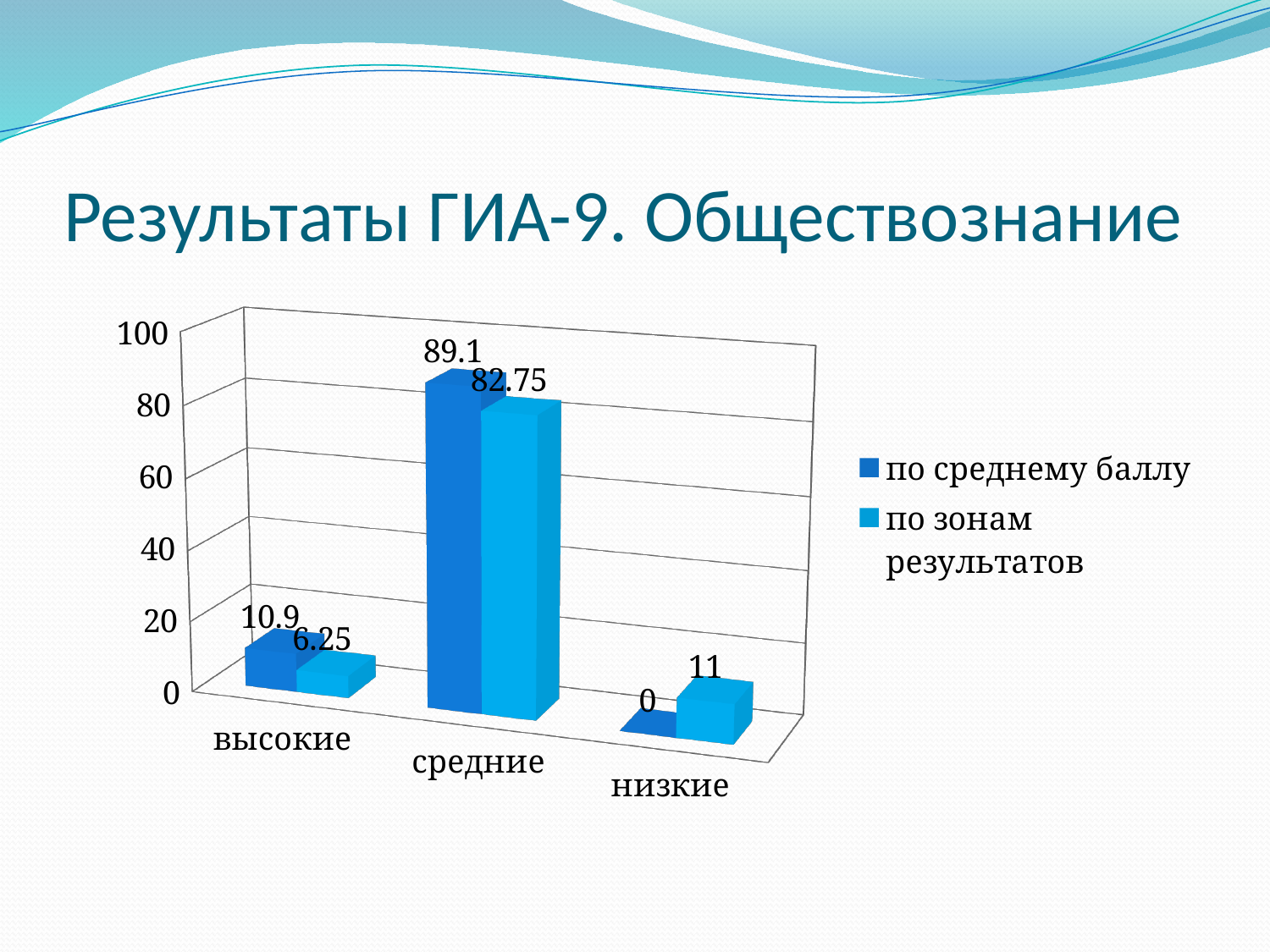
Which category has the highest value in the "по среднему баллу" series? средние What is the value for "высокие" in the "по среднему баллу" series? 10.9 What is the difference between the "по среднему баллу" and "по зонам результатов" values for "средние"? 6.35 What is the value for "средние" in the "по среднему баллу" series? 89.1 For "высокие", which series has the larger value: "по среднему баллу" or "по зонам результатов"? по среднему баллу What is the value for "средние" in the "по зонам результатов" series? 82.75 What is the value for "низкие" in the "по зонам результатов" series? 11 Which category has the lowest value in the "по зонам результатов" series? высокие What is the value for "низкие" in the "по среднему баллу" series? 0 What kind of chart is shown on the slide? bar chart How many series does the legend list? 2 How many categories are shown on the x axis? 3